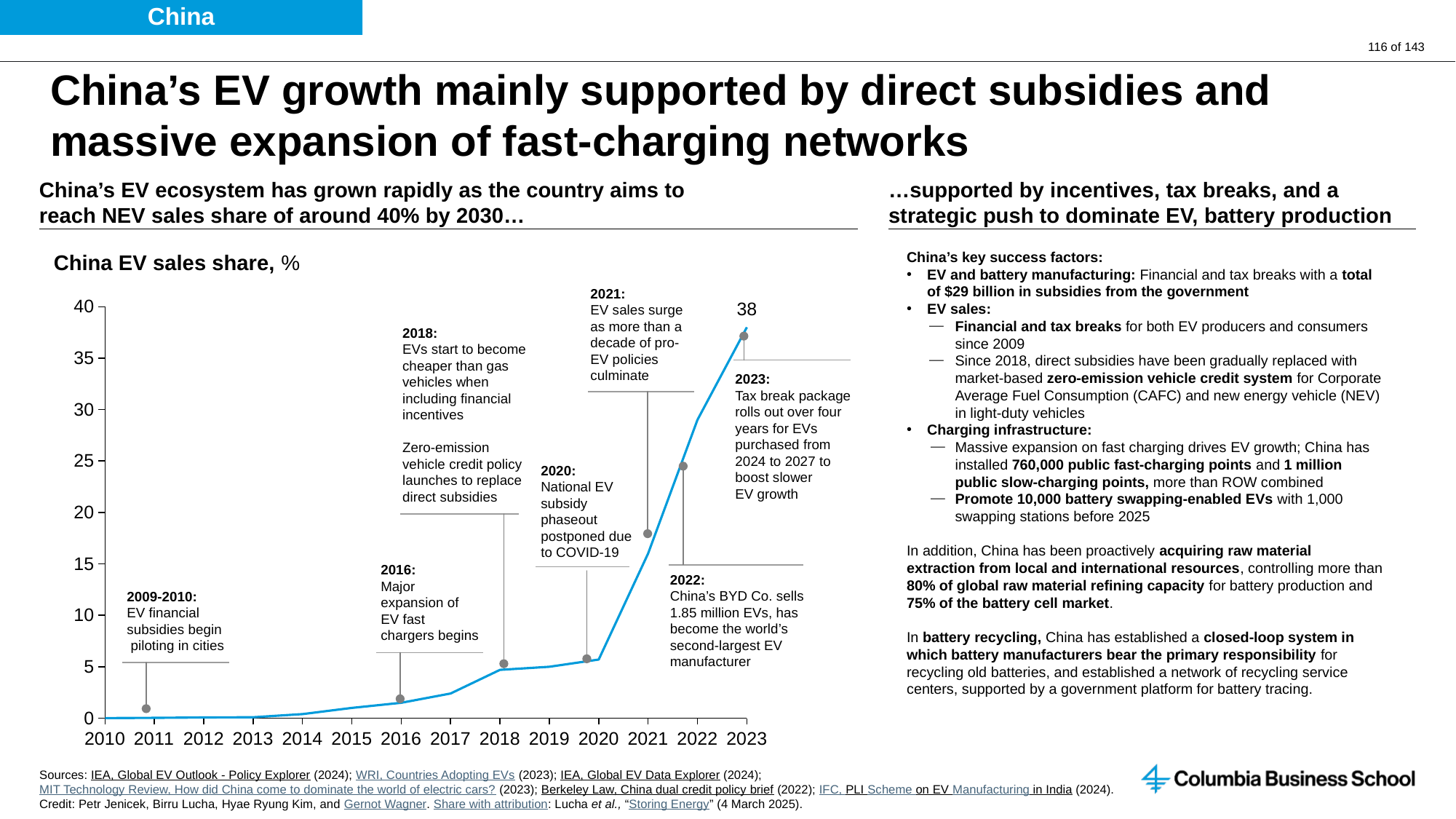
Is the China EV sales share for 2016 greater or less than 5? less How many years are shown on the x axis of the China EV sales share chart? 14 Does China's EV sales share rise or fall from 2010 to 2023? rise Is the China EV sales share for 2021 greater or less than 15? greater What is the highest value shown on the y axis of the chart? 40 What is the China EV sales share shown for 2023? 38 Which year has the highest China EV sales share? 2023 What is the title of the chart? China EV sales share, % Which year has the larger China EV sales share, 2018 or 2022? 2022 Is the China EV sales share for 2018 greater or less than 10? less What kind of chart is used to show China EV sales share? line chart